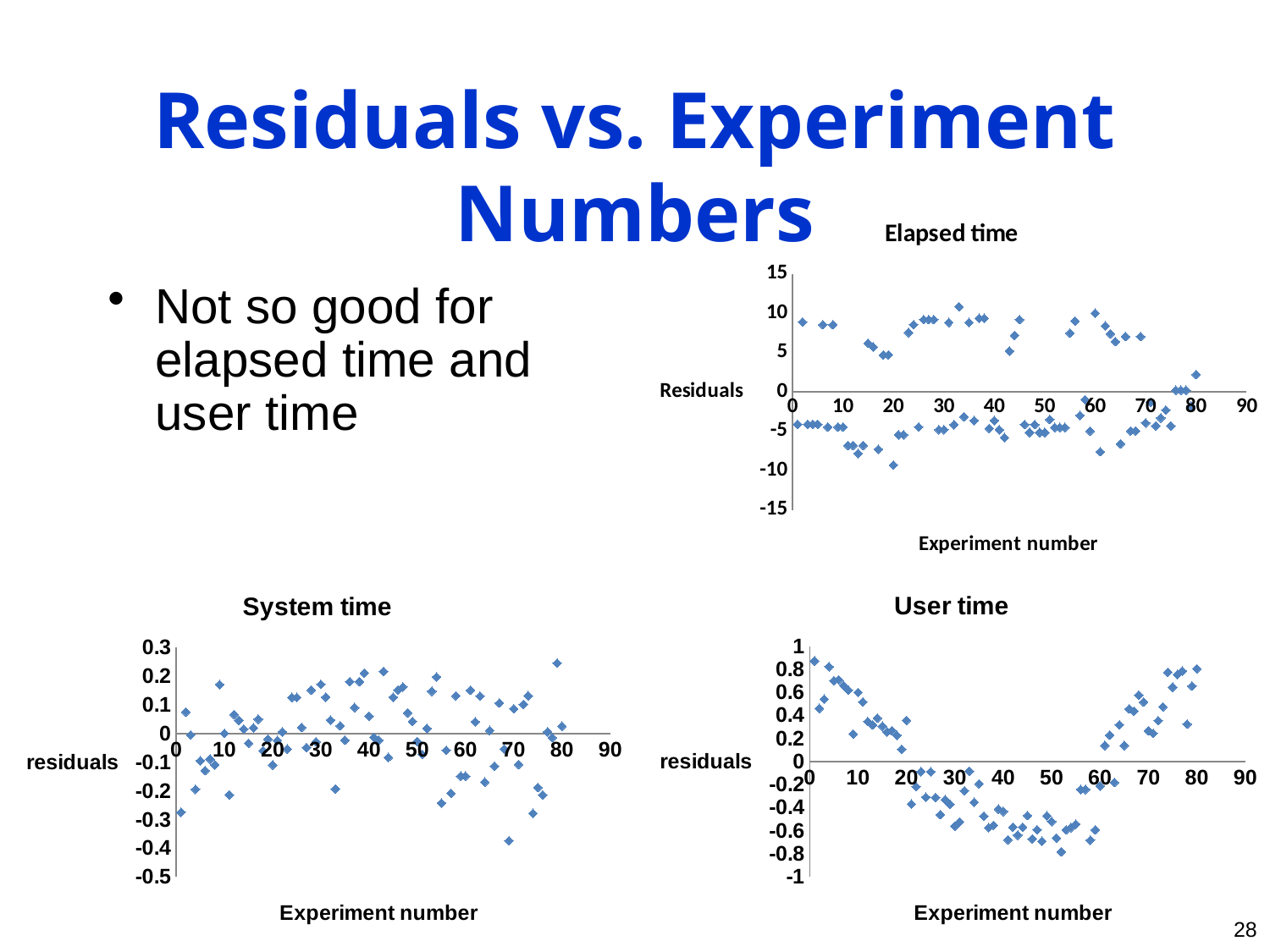
In the 'User time' chart, is the residual for experiment number 1 greater or less than 0.5? greater What is the x-axis label of the 'User time' chart? Experiment number What kind of chart is the 'System time' chart? scatter chart What kind of chart is the 'Elapsed time' chart? scatter chart In the 'User time' chart, is the residual for experiment number 50 greater or less than 0? less In the 'Elapsed time' chart, is the lowest residual greater or less than -5? less In the 'User time' chart, do the residuals rise or fall as the experiment number goes from 0 to 20? fall In the 'User time' chart, do the residuals rise or fall as the experiment number goes from 60 to 80? rise How many charts are shown on the slide? 3